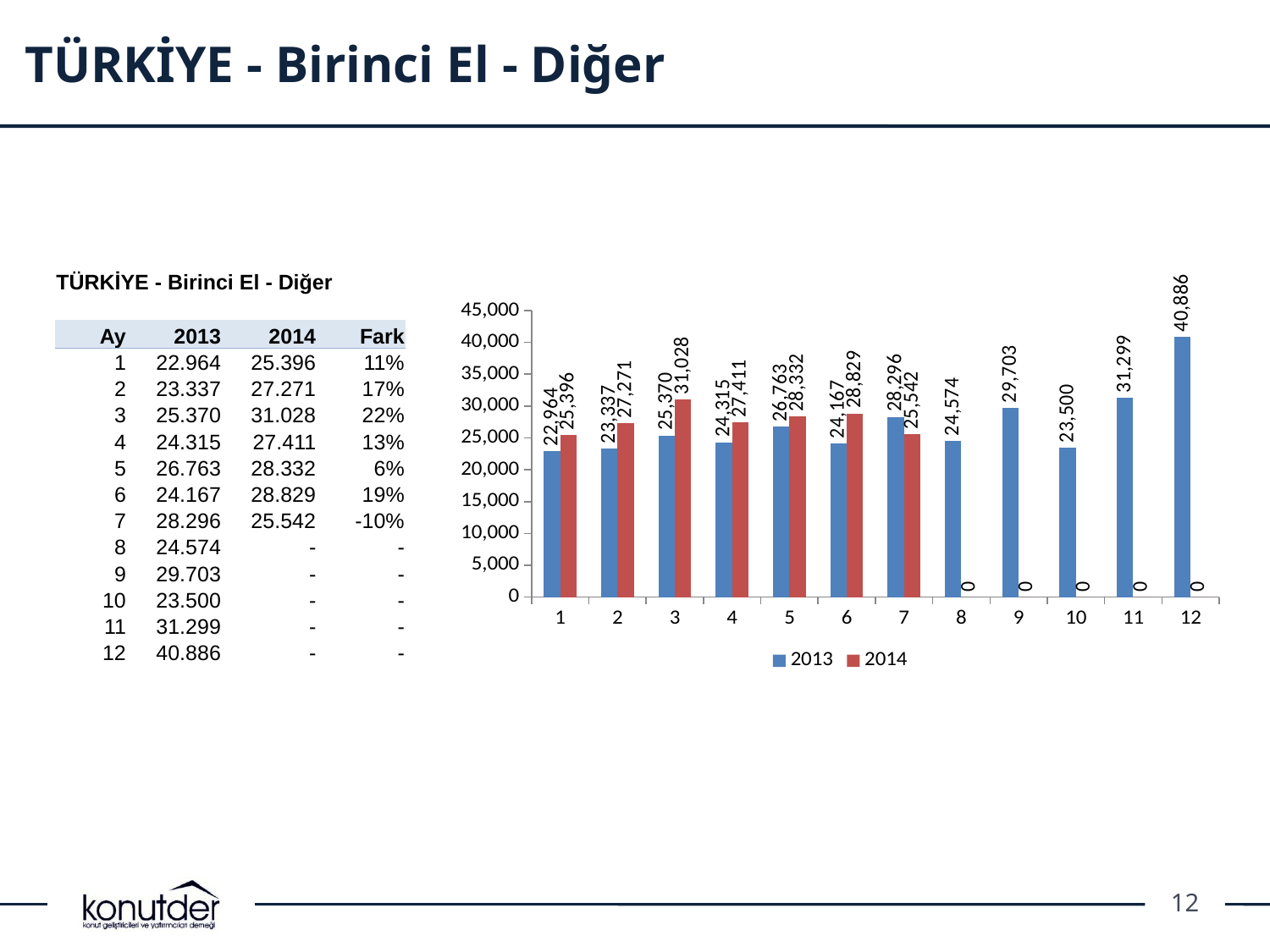
Which month has the highest 2013 value? 12 What is the difference between the 2014 and 2013 values in month 3? 5,658 What is the value for 2013 in month 9? 29,703 How many months are shown on the x axis? 12 Which month has the lowest 2013 value? 1 Which month has the highest 2014 value? 3 Is the 2013 value for month 11 greater or less than 30,000? greater What is the value for 2013 in month 12? 40,886 In month 7, which series has the larger value, 2013 or 2014? 2013 How many series does the legend list? 2 What is the value for 2014 in month 3? 31,028 What kind of chart is shown on the slide? bar chart